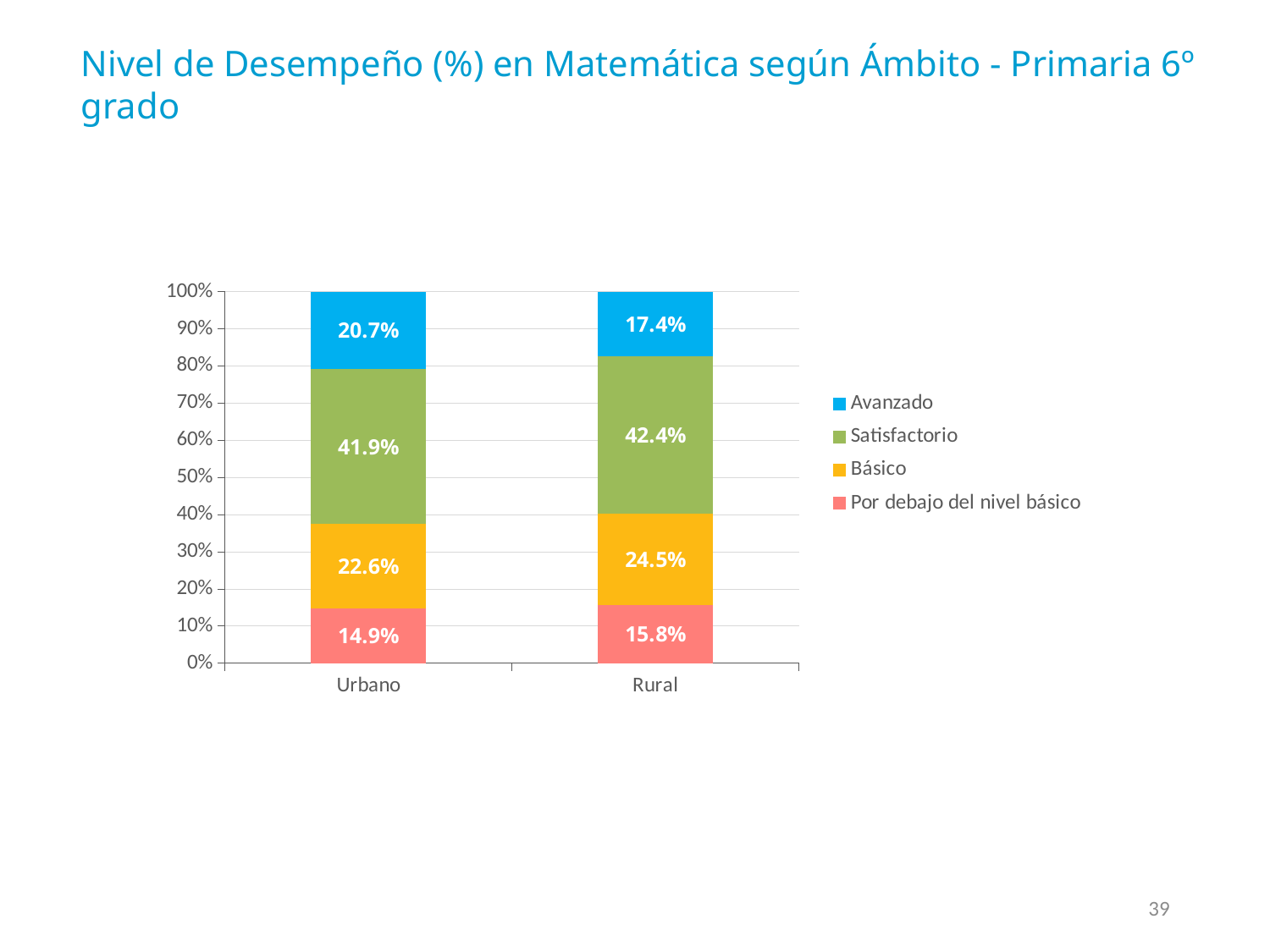
What is the Básico percentage for Urbano? 22.6% What is the difference in the Avanzado percentage between Urbano and Rural? 3.3 percentage points How many categories are shown on the x axis? 2 Which performance level has the largest share in the Urbano bar? Satisfactorio Which performance level has the smallest share in the Rural bar? Por debajo del nivel básico What is the 'Por debajo del nivel básico' percentage for Rural? 15.8% How many series does the legend list? 4 Which has a higher Avanzado percentage, Urbano or Rural? Urbano What kind of chart is shown on the slide? Stacked bar chart What is the difference in the Básico percentage between Rural and Urbano? 1.9 percentage points What is the Avanzado percentage for Urbano? 20.7% What is the Satisfactorio percentage for Rural? 42.4%